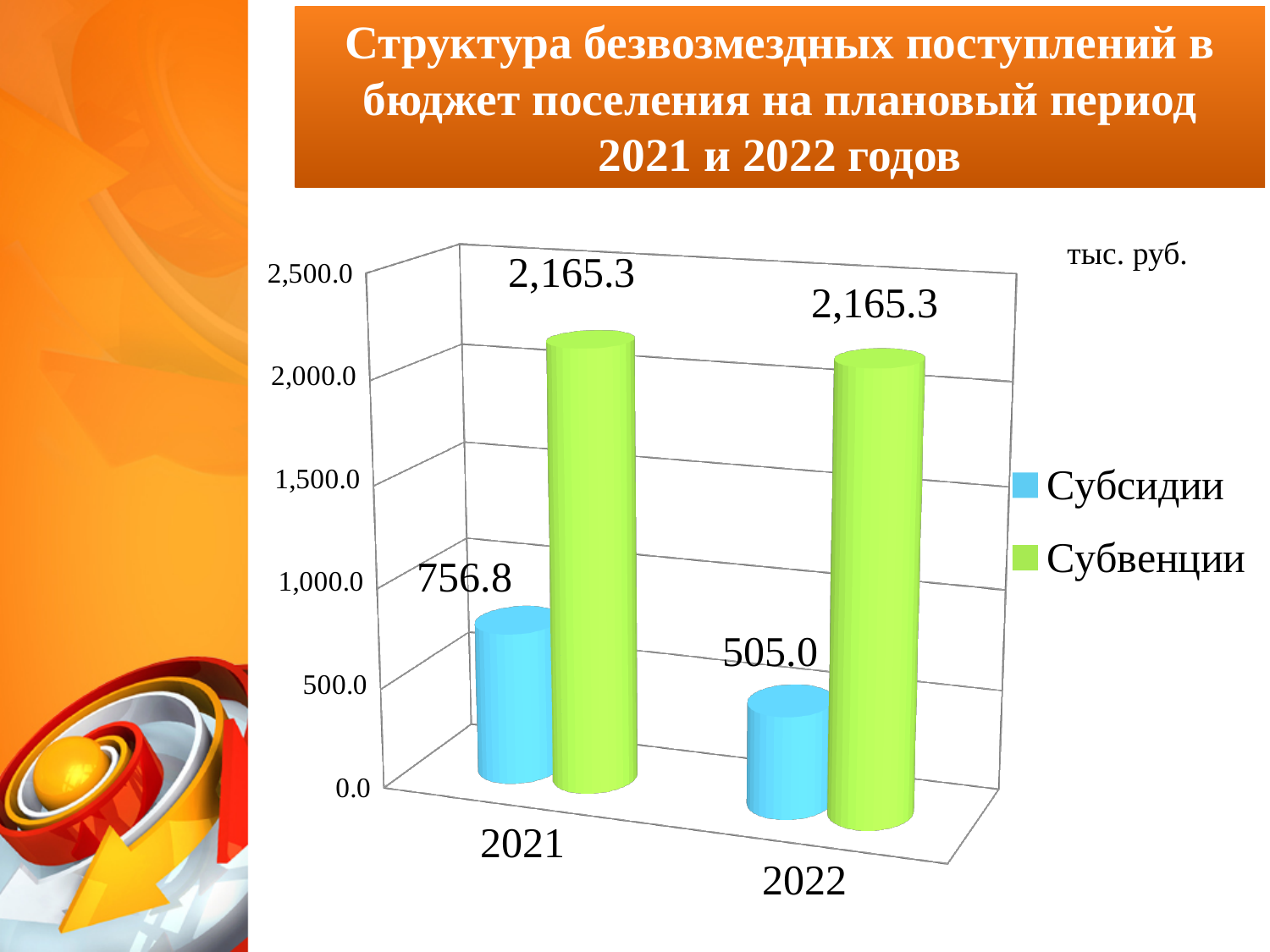
Does the value for Субсидии rise or fall from 2021 to 2022? fall What unit is indicated for the values on the chart? тыс. руб. What kind of chart is shown on the slide? bar chart What is the difference between the Субсидии values for 2021 and 2022? 251.8 In which year is the value for Субсидии higher? 2021 Which is larger in 2022, Субсидии or Субвенции? Субвенции What is the value for Субсидии in 2022? 505.0 What is the value for Субсидии in 2021? 756.8 How many years are shown on the x axis? 2 What is the value for Субвенции in 2022? 2,165.3 How many series does the legend list? 2 What is the value for Субвенции in 2021? 2,165.3